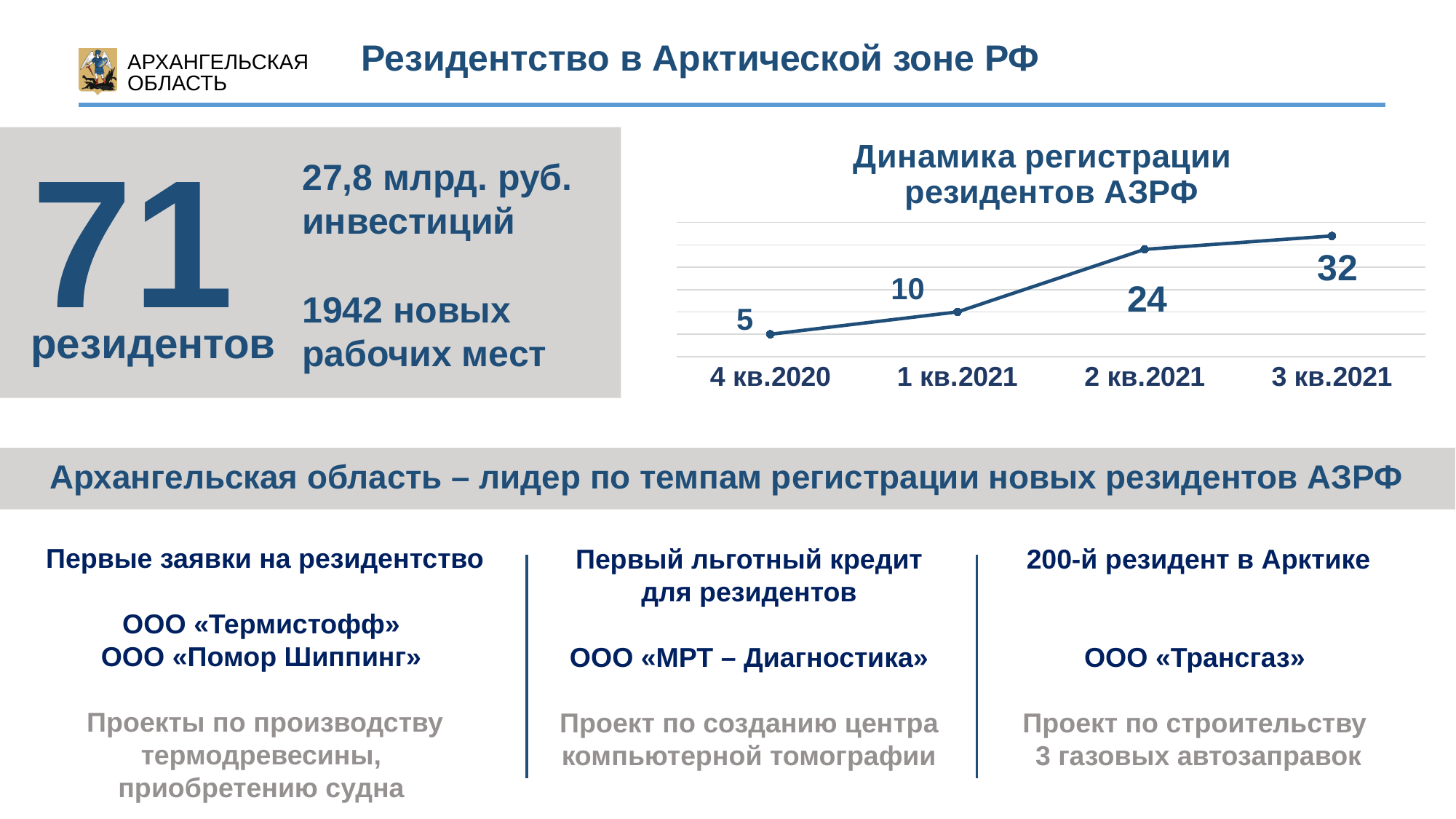
How many data points are plotted on the chart? 4 Which quarter has the lowest value? 4 кв.2020 What is the value for 1 кв.2021? 10 What is the value for 2 кв.2021? 24 What is the value for 4 кв.2020? 5 Do the values rise or fall from 4 кв.2020 to 3 кв.2021? rise What is the value for 3 кв.2021? 32 What is the title of the chart? Динамика регистрации резидентов АЗРФ Which quarter has the highest value? 3 кв.2021 Which is larger, the value for 2 кв.2021 or the value for 3 кв.2021? 3 кв.2021 What is the difference between the values for 2 кв.2021 and 1 кв.2021? 14 What kind of chart is shown? line chart